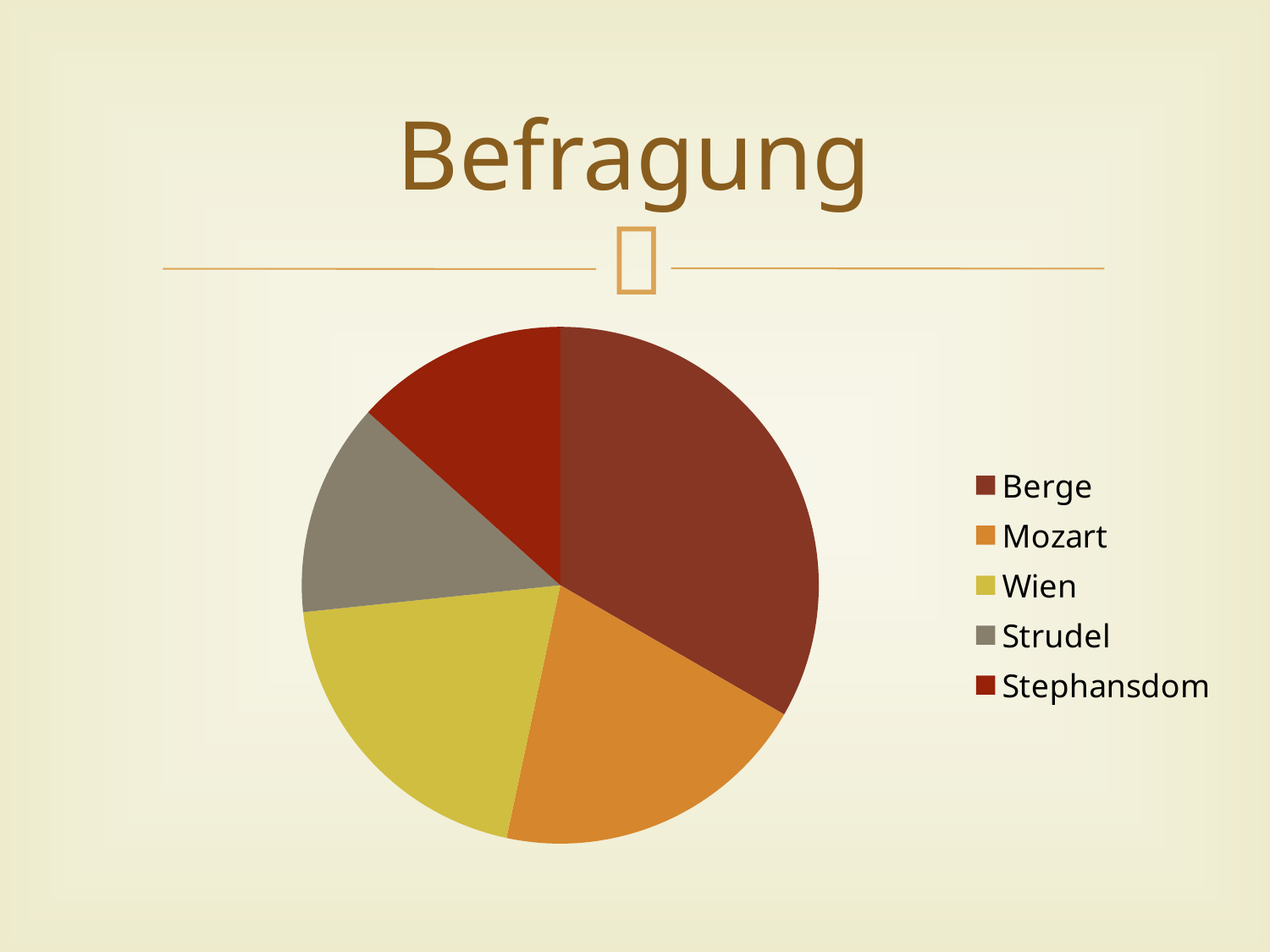
Which slice is larger, Berge or Stephansdom? Berge Which slice is larger, Berge or Mozart? Berge How many categories does the pie chart have? 5 What kind of chart is shown on the slide? pie chart Which category has the largest slice of the pie chart? Berge Which slice is larger, Wien or Strudel? Wien What is the title of the slide containing the pie chart? Befragung Which category is listed last in the legend of the pie chart? Stephansdom Which category is shown in the yellow slice of the pie chart? Wien